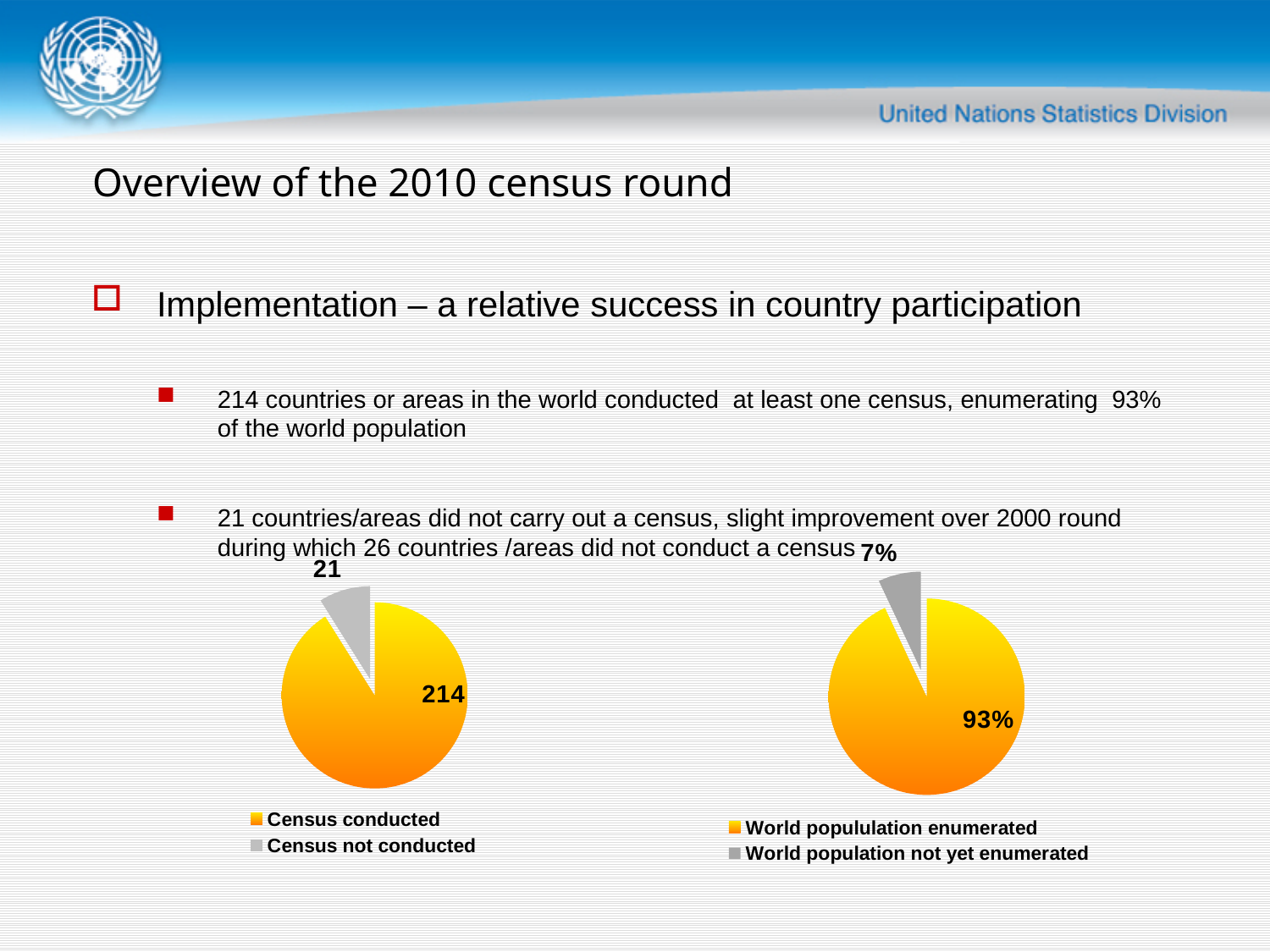
In the left pie chart, what is the value for Census not conducted? 21 In the left pie chart, which category has the largest slice? Census conducted In the left pie chart, what is the difference between Census conducted and Census not conducted? 193 In the right pie chart, what share is World population not yet enumerated? 7% In the left pie chart, what is the value for Census conducted? 214 In the left pie chart, which is larger: Census conducted or Census not conducted? Census conducted What type of chart is shown on the left of the slide? Pie chart How many categories does the legend of the right pie chart list? 2 In the right pie chart, what share is World population enumerated? 93% In the right pie chart, what is the difference between the enumerated and not yet enumerated shares? 86% In the left pie chart, what colour is the Census not conducted slice? Grey In the right pie chart, which category has the smallest slice? World population not yet enumerated